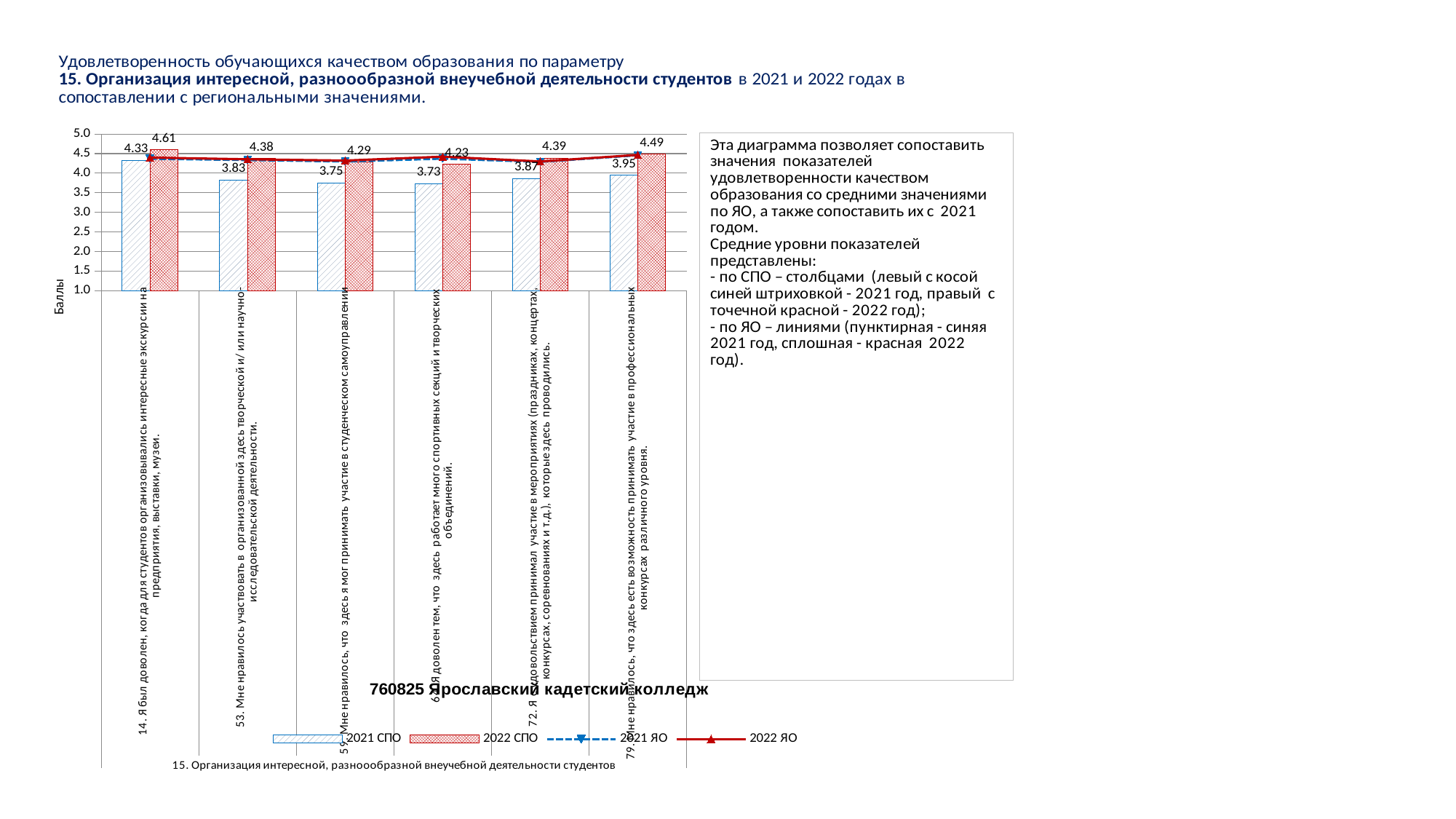
What is the 2022 СПО value for item 79 (Мне нравилось, что здесь есть возможность принимать участие в профессиональных конкурсах различного уровня)? 4.49 Is the 2021 ЯО line value for item 14 greater or less than 4.0? greater How many categories are plotted on the x axis? 6 For item 72, which is larger: the 2021 СПО value or the 2022 СПО value? 2022 СПО (4.39) What is the title of the vertical axis? Баллы What is the difference between the 2022 СПО and 2021 СПО values for item 79? 0.54 Which category has the highest 2022 СПО value? 14. Я был доволен, когда для студентов организовывались интересные экскурсии на предприятия, выставки, музеи (4.61) What is the 2022 СПО value for item 14 (Я был доволен, когда для студентов организовывались интересные экскурсии на предприятия, выставки, музеи)? 4.61 What is the 2021 СПО value for item 53 (Мне нравилось участвовать в организованной здесь творческой и/или научно-исследовательской деятельности)? 3.83 What is the difference between the 2022 СПО and 2021 СПО values for item 14? 0.28 What is the lowest 2022 СПО value shown on the chart? 4.23 How many series does the legend list? 4